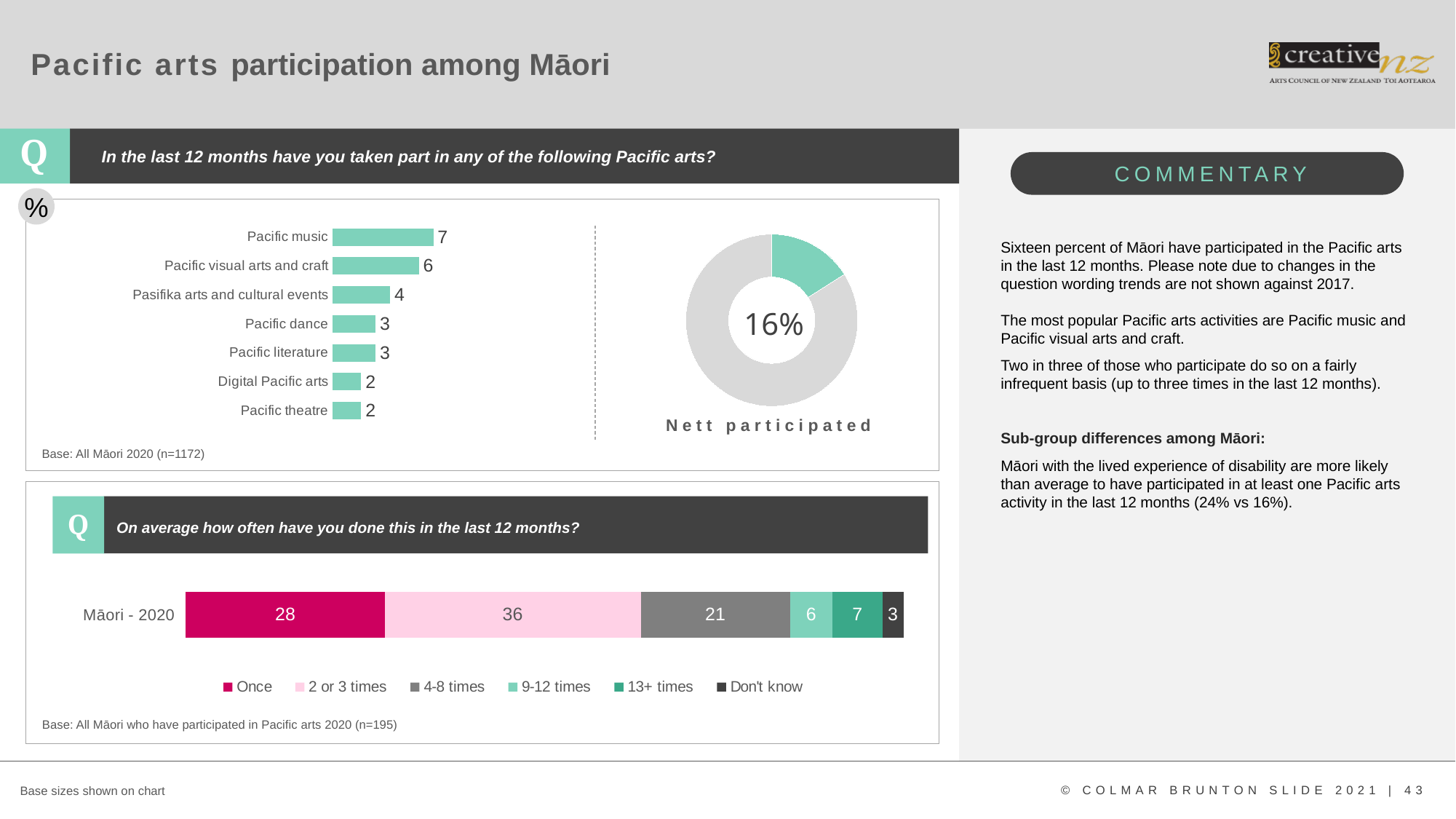
How many series does the legend of the bottom stacked bar chart list? 6 How many categories are shown in the top-left bar chart? 7 In the bottom stacked bar chart, what is the value for '13+ times'? 7 In the bottom stacked bar chart, what is the combined value of 'Once' and '2 or 3 times'? 64 What kind of chart is the top-left chart showing Pacific arts activities? Bar chart In the top-left bar chart, what is the value for Pasifika arts and cultural events? 4 In the top-left bar chart, what is the value for Pacific music? 7 In the top-left bar chart, which is larger: Pacific visual arts and craft or Pacific dance? Pacific visual arts and craft In the 'Nett participated' donut chart, what percentage is shown in the centre? 16% In the bottom stacked bar chart, what is the value for '2 or 3 times' for Māori - 2020? 36 In the top-left bar chart, what is the difference between Pacific music and Pacific theatre? 5 In the top-left bar chart, which category has the highest value? Pacific music